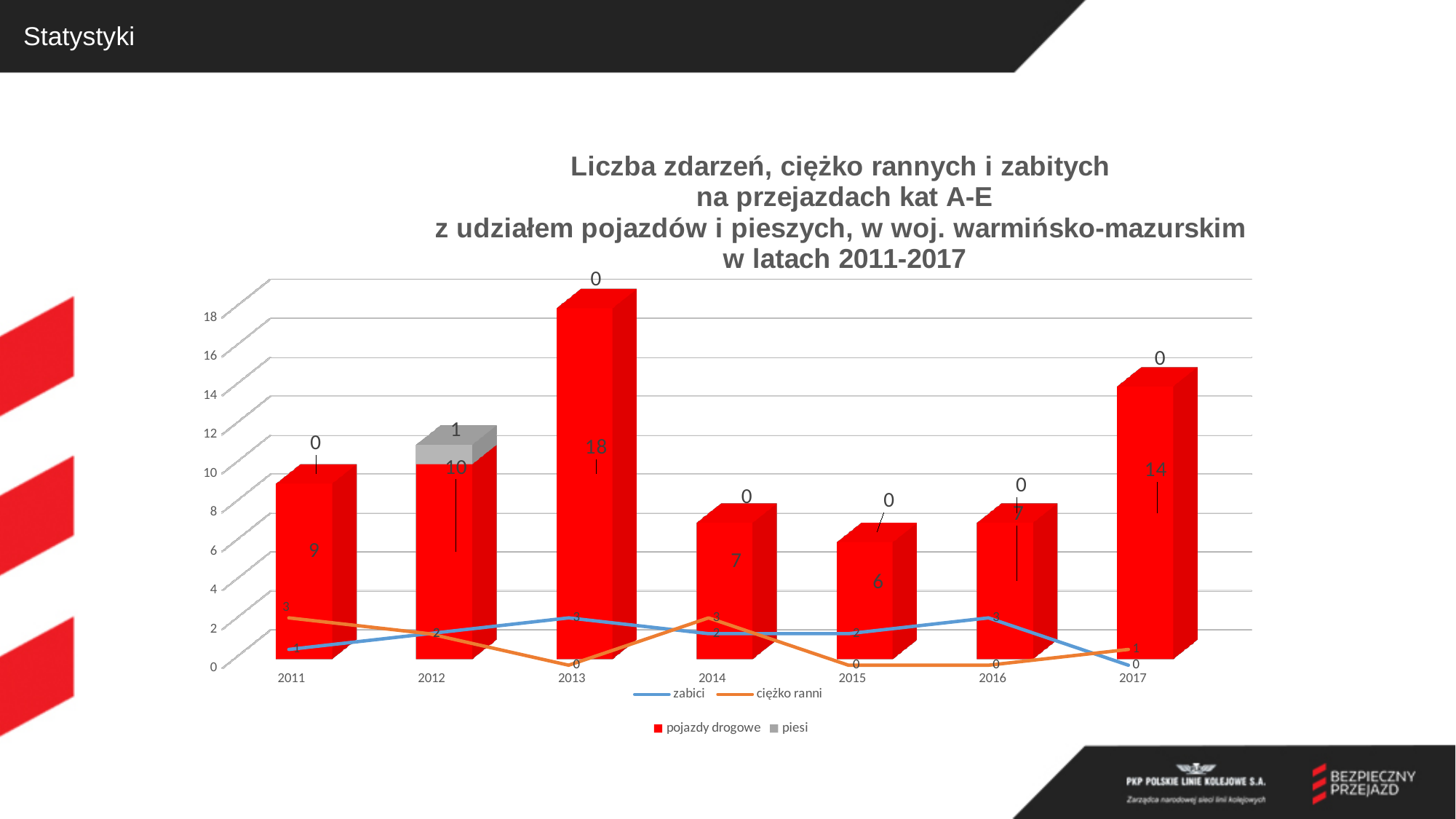
Which year has the lowest value for pojazdy drogowe? 2015 What is the value for ciężko ranni in 2011? 3 How many series does the legend list? 4 What is the value for pojazdy drogowe in 2013? 18 What kind of chart is shown on the slide? Stacked bar chart combined with line chart What is the value for piesi in 2012? 1 Which is larger, the pojazdy drogowe value for 2011 or for 2014? 2011 Which year has the highest value for pojazdy drogowe? 2013 What is the value for pojazdy drogowe in 2017? 14 What is the total of the stacked bar for 2012 (pojazdy drogowe plus piesi)? 11 How many years are shown on the x axis? 7 What is the difference between the pojazdy drogowe values for 2013 and 2017? 4